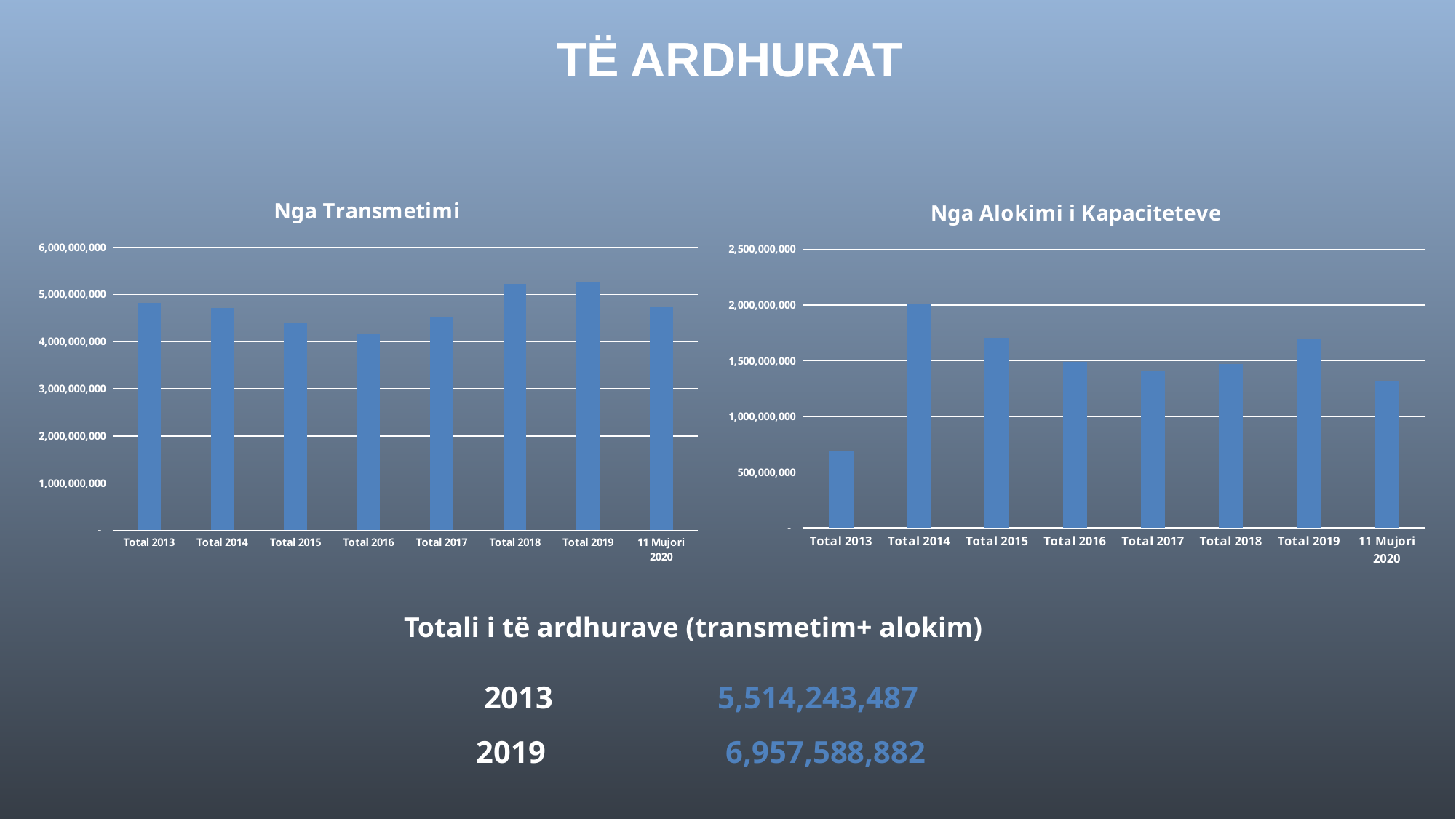
In the 'Nga Alokimi i Kapaciteteve' chart, is the value for 11 Mujori 2020 greater or less than 1,500,000,000? less In the 'Nga Alokimi i Kapaciteteve' chart, which is larger, the value for Total 2015 or Total 2016? Total 2015 How many categories are shown on the x axis of the 'Nga Alokimi i Kapaciteteve' chart? 8 In the 'Nga Transmetimi' chart, is the value for Total 2013 greater or less than 4,000,000,000? greater In the 'Nga Transmetimi' chart, which is larger, the value for Total 2018 or Total 2016? Total 2018 In the 'Nga Transmetimi' chart, is the value for Total 2016 greater or less than 5,000,000,000? less In the 'Nga Alokimi i Kapaciteteve' chart, which category has the lowest value? Total 2013 In the 'Nga Transmetimi' chart, which category has the lowest value? Total 2016 What is the title of the chart on the right side of the slide? Nga Alokimi i Kapaciteteve What kind of chart is the 'Nga Transmetimi' chart? bar chart In the 'Nga Alokimi i Kapaciteteve' chart, which category has the highest value? Total 2014